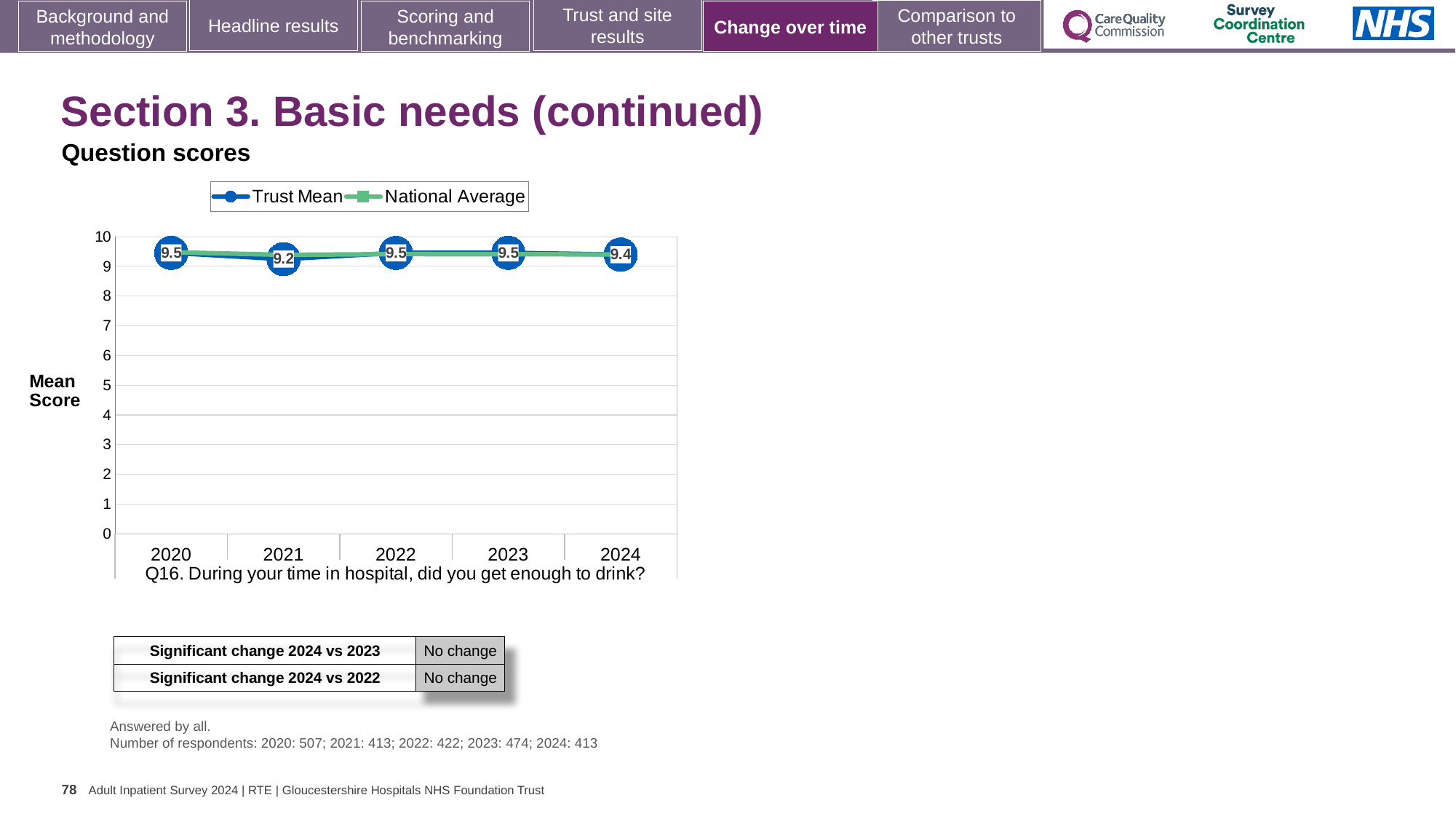
Which year has the larger Trust Mean score, 2021 or 2024? 2024 What is the Trust Mean score for 2021? 9.2 In which year is the Trust Mean score lowest? 2021 What is the label on the y axis of the chart? Mean Score What is the Trust Mean score for 2020? 9.5 How many years are plotted on the x axis? 5 What kind of chart is shown on the slide? line chart What is the difference between the Trust Mean scores for 2020 and 2021? 0.3 Does the Trust Mean score rise or fall from 2023 to 2024? fall What is the Trust Mean score for 2024? 9.4 Is the National Average value for 2022 greater or less than 5? greater How many series does the legend list? 2